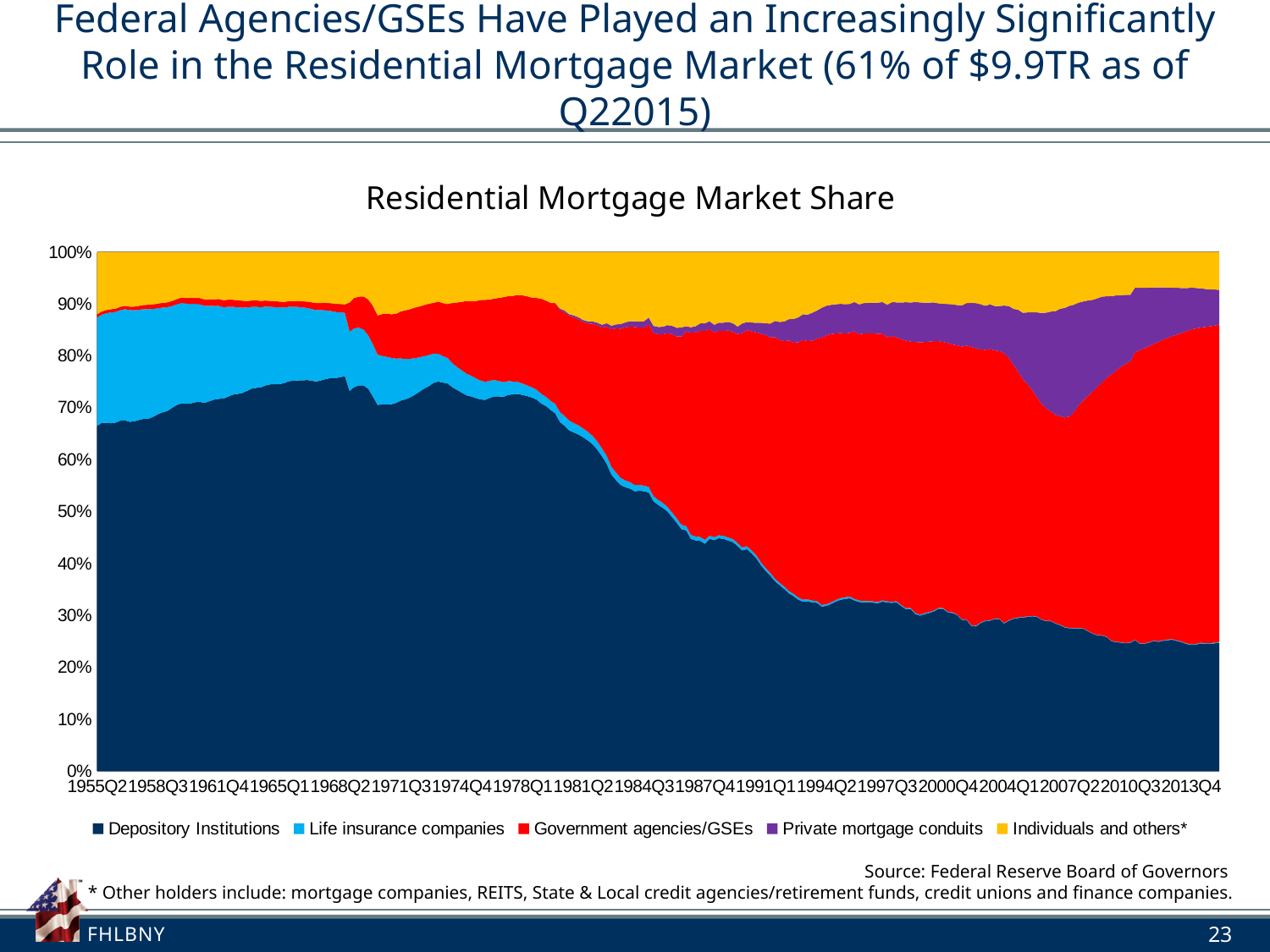
What kind of chart is shown on the slide? Stacked area chart How many date labels are shown along the x axis? 19 Which colour represents Government agencies/GSEs in the chart? Red Is the share of Depository Institutions at 1981Q2 greater or less than 60%? greater Is the share of Depository Institutions at 1955Q2 greater or less than 60%? greater Is the share of Depository Institutions at 2013Q4 greater or less than 30%? less At the left end of the chart (1955Q2), which series has the largest share? Depository Institutions How many series does the legend list? 5 At the right end of the chart (2013Q4), which series has the larger share: Depository Institutions or Government agencies/GSEs? Government agencies/GSEs Does the share of Depository Institutions rise or fall from 1955Q2 to 2013Q4? Fall What is the title of the chart? Residential Mortgage Market Share Does the share of Government agencies/GSEs rise or fall from 1955Q2 to 2013Q4? Rise